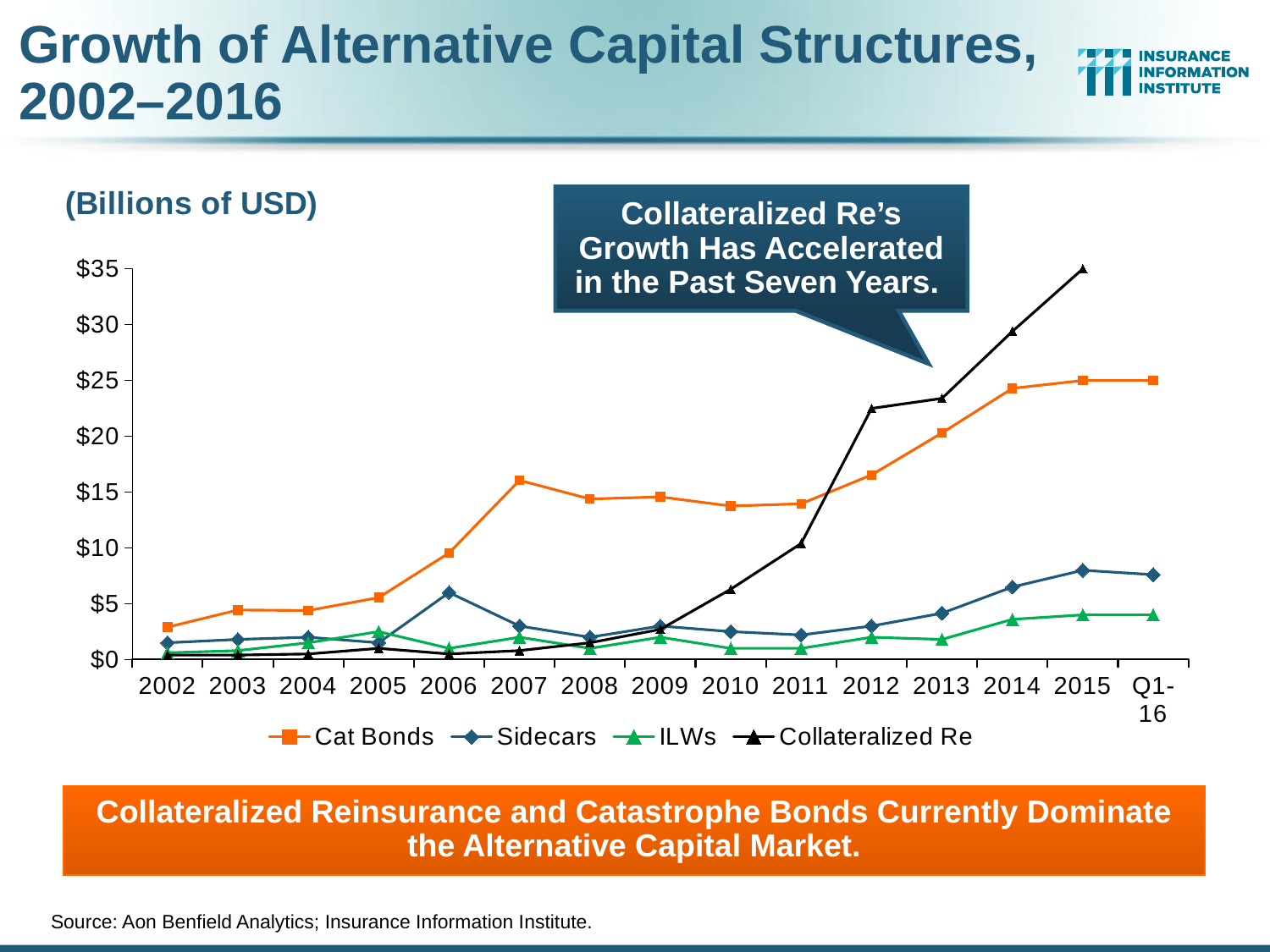
Does the Collateralized Re series rise or fall from 2010 to 2015? rise Is the value for Collateralized Re in 2014 greater or less than $25? greater How many time points are plotted along the x axis? 15 In 2011, which is larger: Cat Bonds or Collateralized Re? Cat Bonds How many series does the legend list? 4 Which series has the highest value in 2015? Collateralized Re What kind of chart is shown on the slide? line chart Which series has the lowest value in 2012? ILWs What unit is stated above the chart? Billions of USD Is the value for Cat Bonds in 2010 greater or less than $15? less Is the value for Sidecars in 2006 greater or less than $5? greater Which series has the highest value in 2007? Cat Bonds